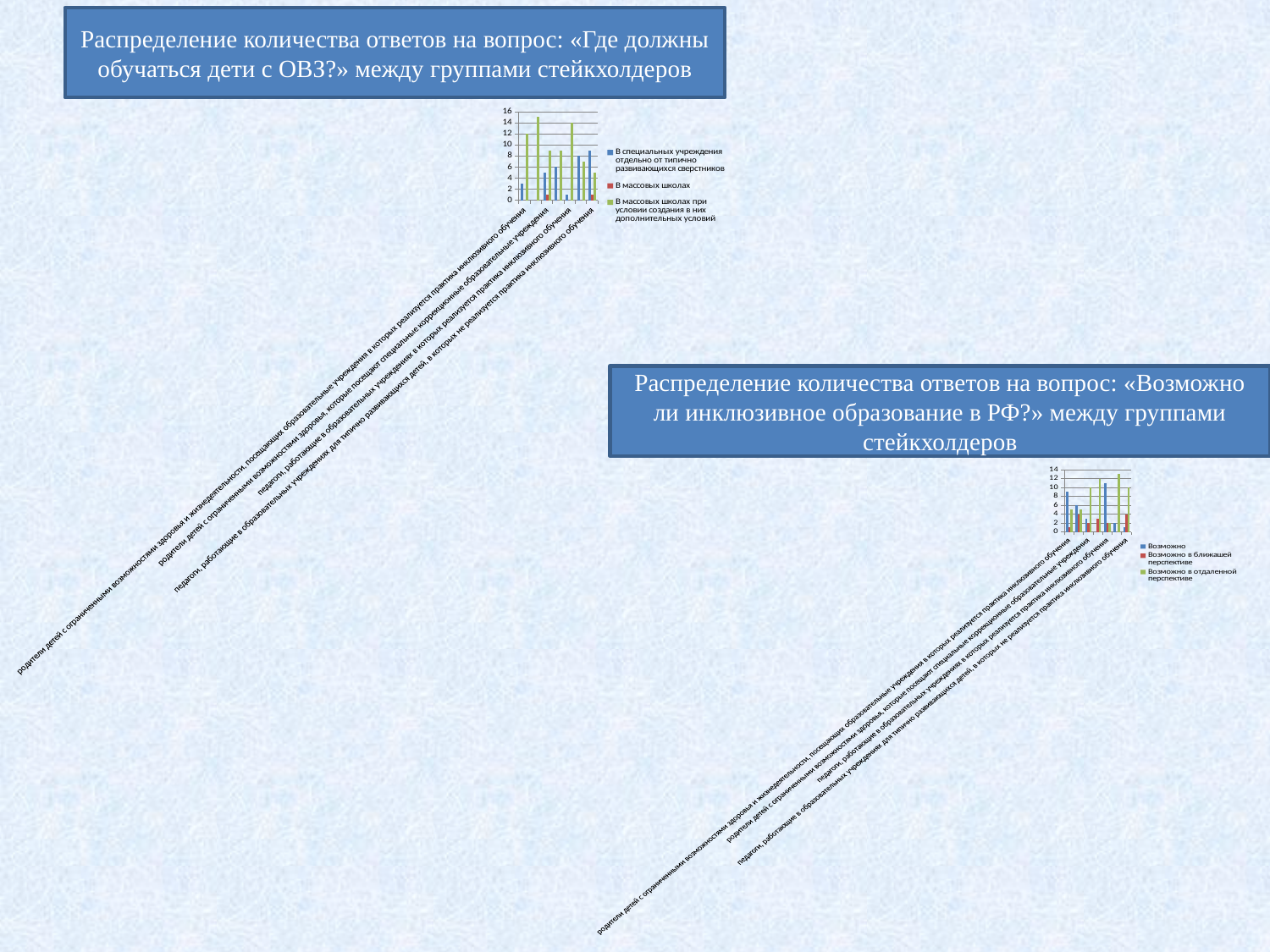
In the chart «Где должны обучаться дети с ОВЗ?», is the value of the green series for the first stakeholder group greater or less than 10? greater In the chart «Где должны обучаться дети с ОВЗ?», which legend entry is shown in green? В массовых школах при условии создания в них дополнительных условий In the chart «Где должны обучаться дети с ОВЗ?», which series contains the tallest bar on the chart? В массовых школах при условии создания в них дополнительных условий What kind of chart is shown under the title «Где должны обучаться дети с ОВЗ?»? bar chart How many series does the legend list in the chart «Где должны обучаться дети с ОВЗ?»? 3 How many series does the legend list in the chart «Возможно ли инклюзивное образование в РФ?»? 3 How many stakeholder groups (categories) are plotted on the x axis of the chart «Возможно ли инклюзивное образование в РФ?»? 7 How many stakeholder groups (categories) are plotted on the x axis of the chart «Где должны обучаться дети с ОВЗ?»? 7 In the chart «Где должны обучаться дети с ОВЗ?», is the value of the red series (В массовых школах) for the first stakeholder group greater or less than 4? less In the chart «Возможно ли инклюзивное образование в РФ?», which legend entry is shown in red? Возможно в ближашей перспективе What kind of chart is shown under the title «Возможно ли инклюзивное образование в РФ?»? bar chart